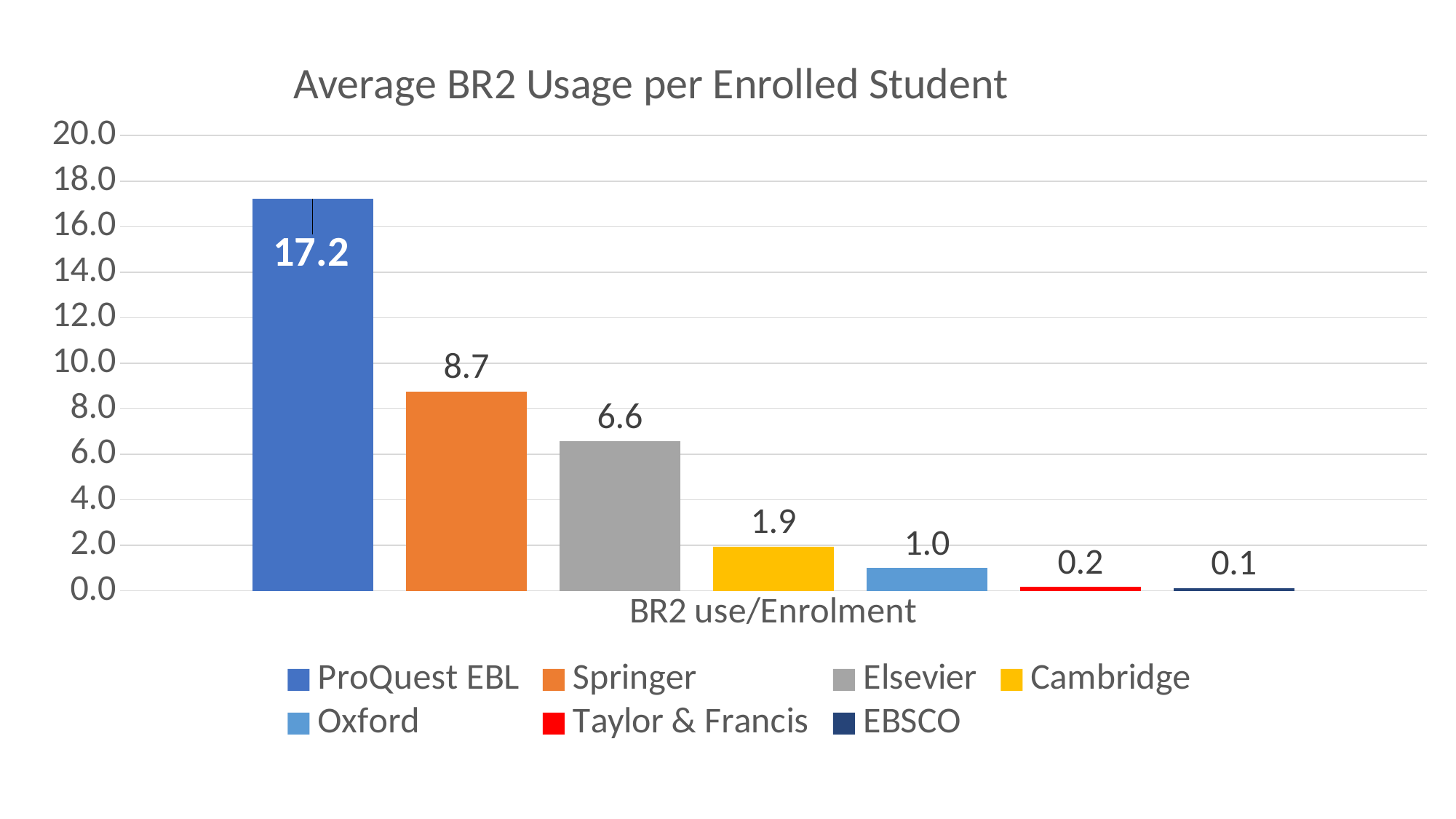
What is the average BR2 usage per enrolled student for ProQuest EBL? 17.2 Which publisher has the highest average BR2 usage per enrolled student? ProQuest EBL Which has a larger value, Springer or Elsevier? Springer What is the value shown for Springer? 8.7 What is the value shown for Taylor & Francis? 0.2 Which publisher has the lowest average BR2 usage per enrolled student? EBSCO What kind of chart is shown on the slide? Bar chart What is the difference between the values for Elsevier and Cambridge? 4.7 What is the difference between the values for ProQuest EBL and Springer? 8.5 What is the title of the chart? Average BR2 Usage per Enrolled Student How many publishers are plotted in the chart? 7 What is the value shown for Cambridge? 1.9